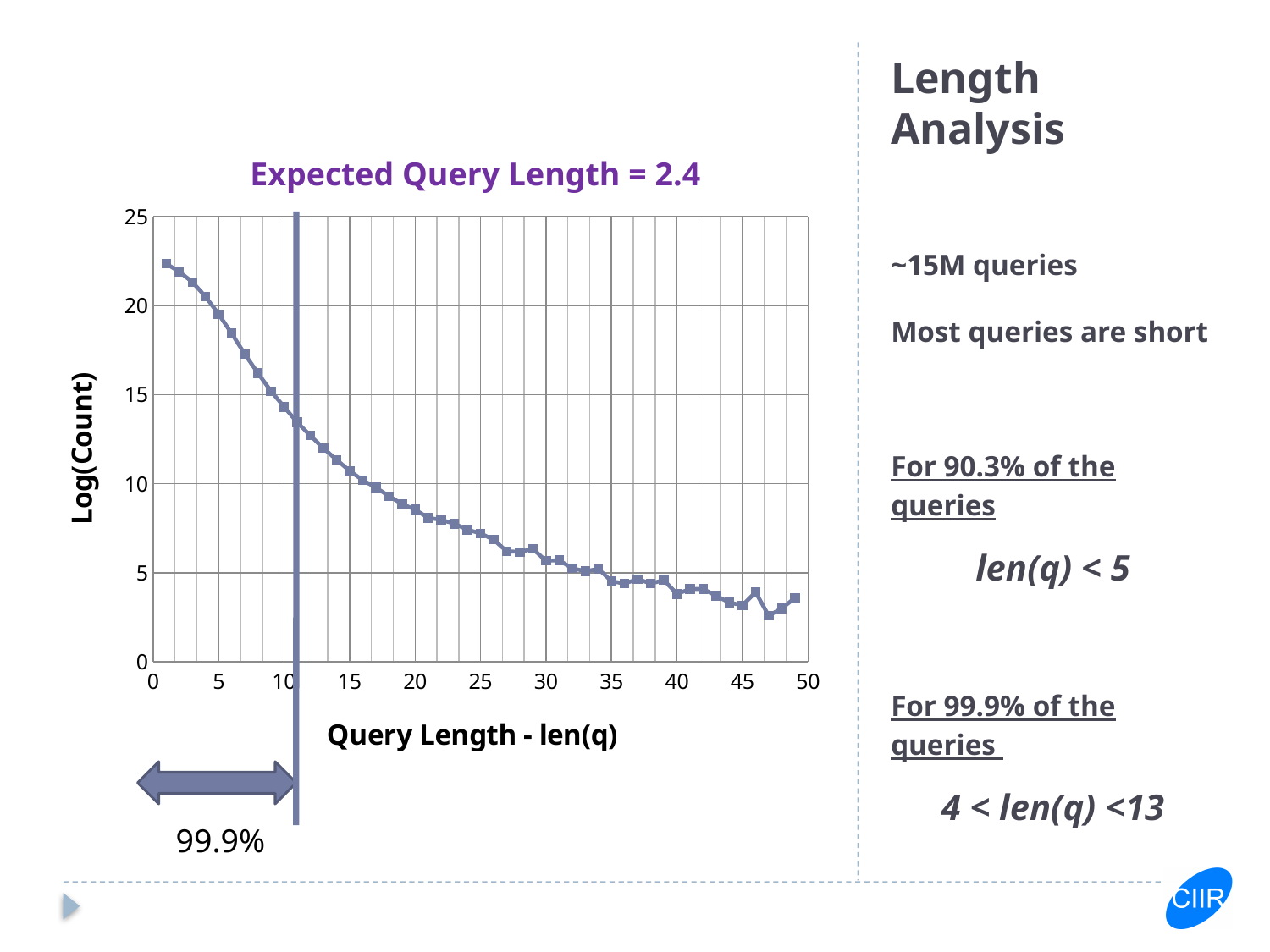
Do the Log(Count) values rise or fall as query length increases along the x axis? fall What is the label of the vertical axis of the chart? Log(Count) What is the highest value shown on the vertical axis of the chart? 25 Is the Log(Count) value at query length 1 greater or less than 20? greater Is the Log(Count) value at query length 30 greater or less than 5? greater What is the title of the chart? Expected Query Length = 2.4 Is the Log(Count) value at query length 20 greater or less than 10? less What kind of chart is shown on the slide? line chart At which query length is the Log(Count) value highest? 1 Which has the larger Log(Count) value, query length 5 or query length 25? query length 5